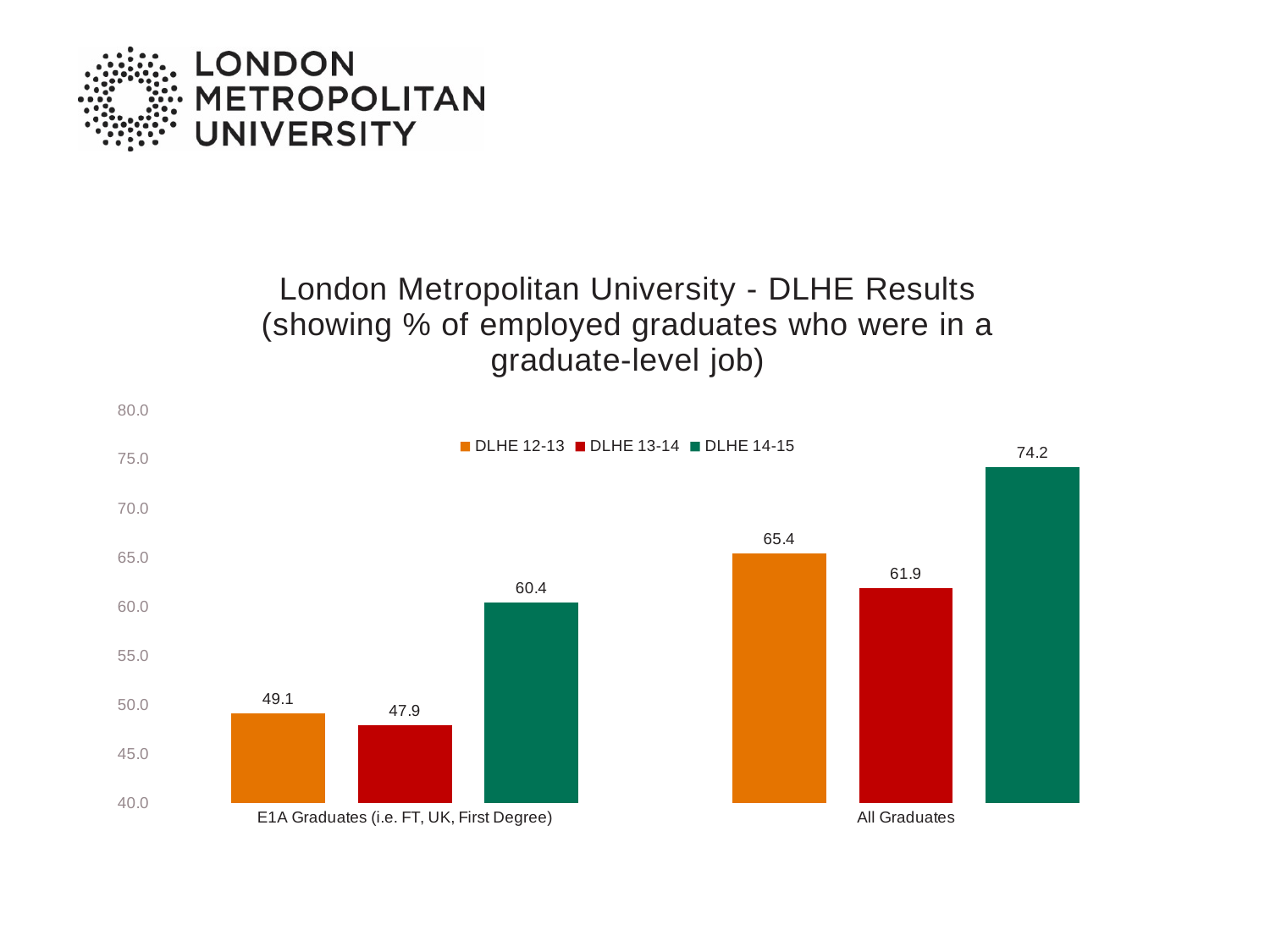
How many categories are shown on the x axis? 2 Is the DLHE 14-15 value for E1A Graduates greater or less than 55.0? greater What kind of chart is shown on the slide? Bar chart Which is larger: the DLHE 12-13 value for E1A Graduates or the DLHE 13-14 value for All Graduates? DLHE 13-14 value for All Graduates What is the difference between the DLHE 14-15 values for All Graduates and E1A Graduates? 13.8 What is the DLHE 14-15 value for All Graduates? 74.2 Which series has the lowest value for E1A Graduates (i.e. FT, UK, First Degree)? DLHE 13-14 What is the difference between the DLHE 12-13 and DLHE 13-14 values for All Graduates? 3.5 How many series does the legend list? 3 Which series has the highest value for All Graduates? DLHE 14-15 What is the DLHE 13-14 value for E1A Graduates (i.e. FT, UK, First Degree)? 47.9 What is the DLHE 12-13 value for All Graduates? 65.4